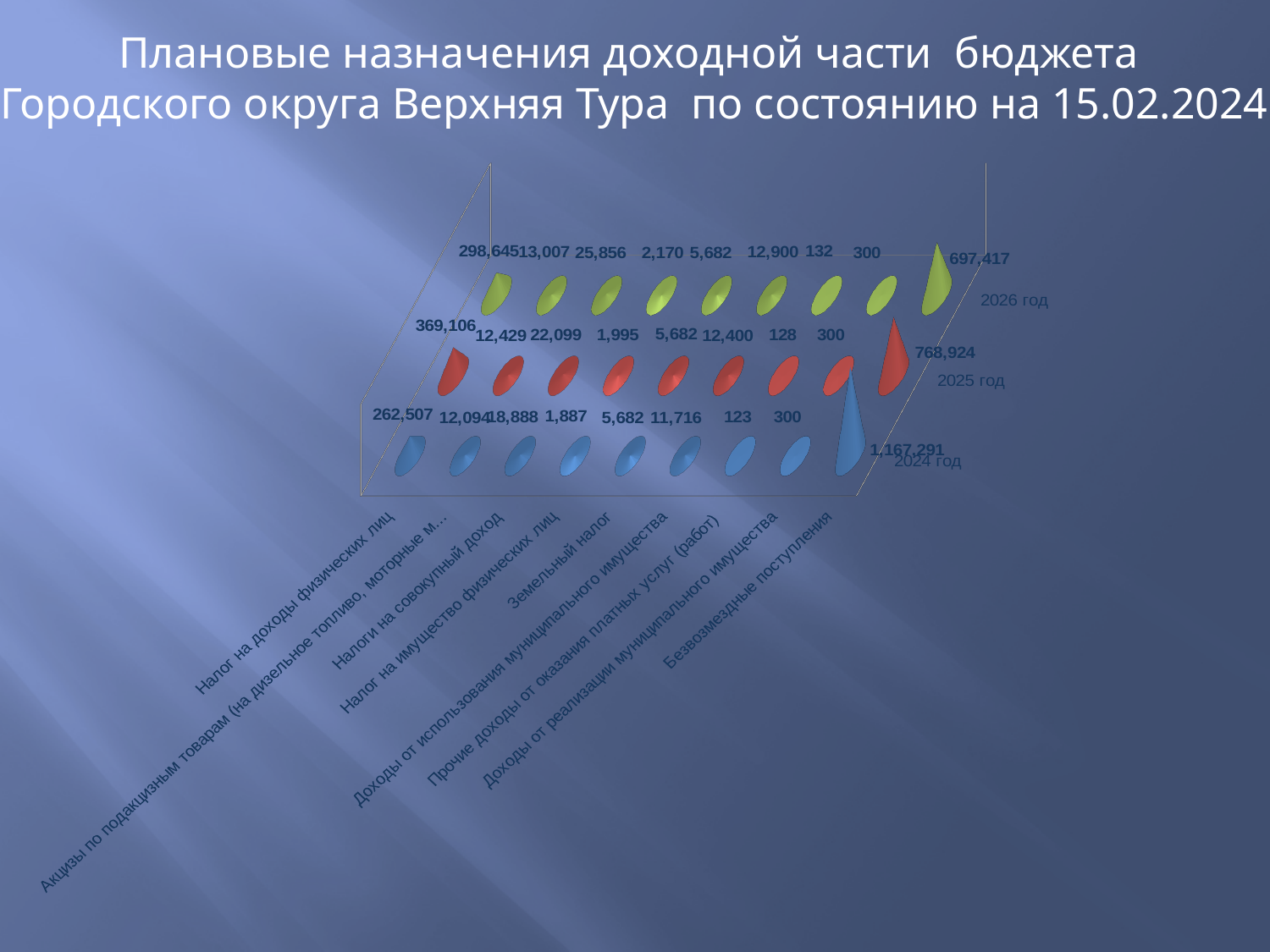
How many series does the chart show? 3 Do the values for Налоги на совокупный доход rise or fall from 2024 год to 2026 год? rise What is the value for Налог на доходы физических лиц in 2025 год? 369,106 What is the value for Налоги на совокупный доход in 2026 год? 25,856 Which category has the lowest value in 2025 год? Прочие доходы от оказания платных услуг (работ) How many categories are shown on the x axis? 9 What is the value for Безвозмездные поступления in 2024 год? 1,167,291 Which is larger for Безвозмездные поступления: the 2024 год value or the 2026 год value? 2024 год What is the difference between the 2025 год and 2024 год values for Налог на доходы физических лиц? 106,599 What colour represents the 2025 год series? red Which category has the highest value in 2026 год? Безвозмездные поступления What is the value for Земельный налог in 2024 год? 5,682